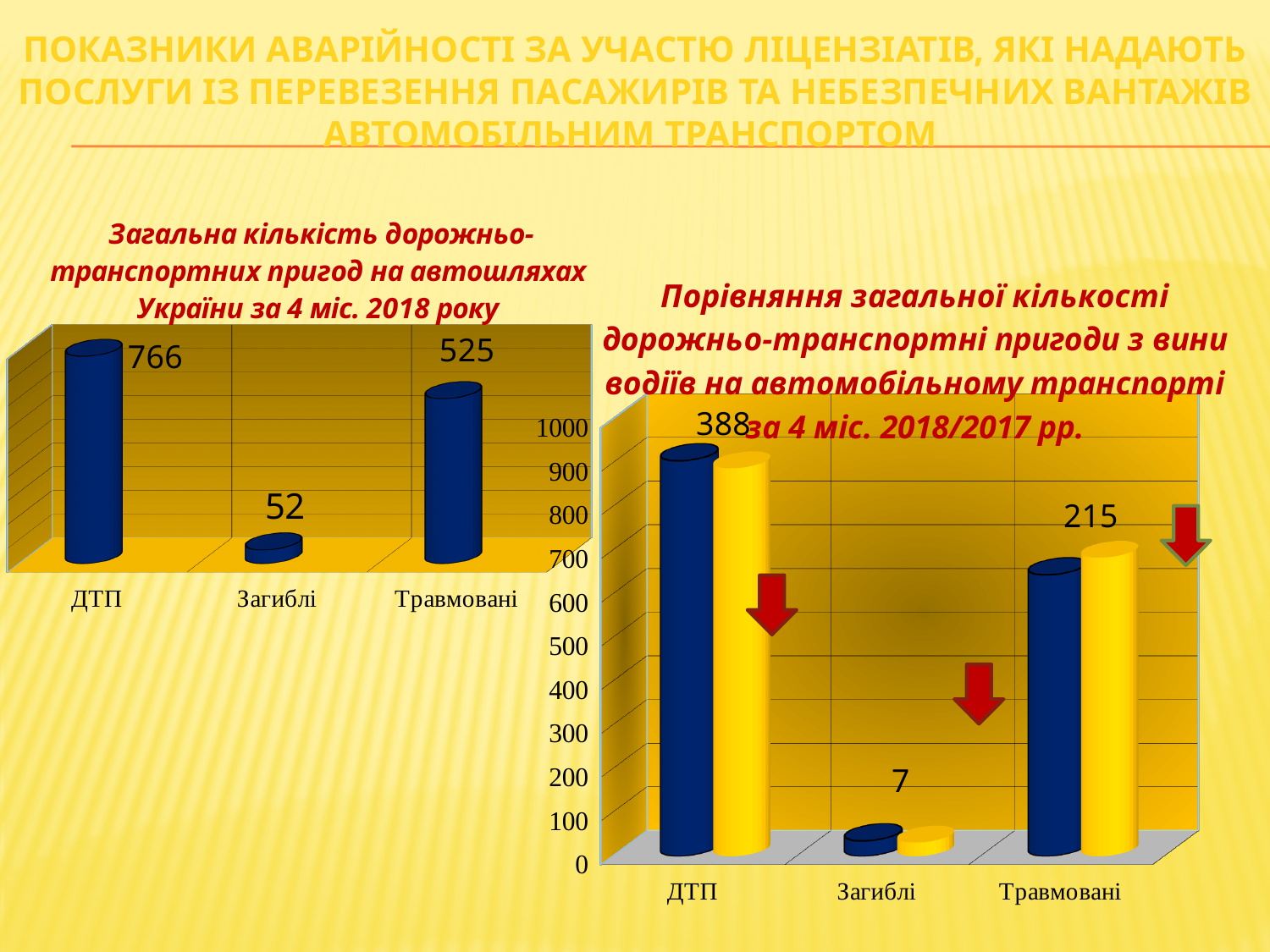
In the left chart, what is the difference between the values for ДТП and Травмовані? 241 In the right chart, is the value of the yellow bar for ДТП greater or less than 800? greater In the left chart, how many categories are shown? 3 In the left chart, what is the value for Загиблі? 52 In the right chart, what is the labelled value for Загиблі? 7 In the left chart (Загальна кількість дорожньо-транспортних пригод на автошляхах України за 4 міс. 2018 року), what is the value for ДТП? 766 In the right chart, what is the labelled value for Травмовані? 215 What type of chart is the right chart? Bar chart In the left chart, what is the value for Травмовані? 525 In the right chart (Порівняння загальної кількості дорожньо-транспортних пригод), what is the labelled value for ДТП? 388 In the left chart, which category has the lowest value? Загиблі In the left chart, which category has the highest value? ДТП